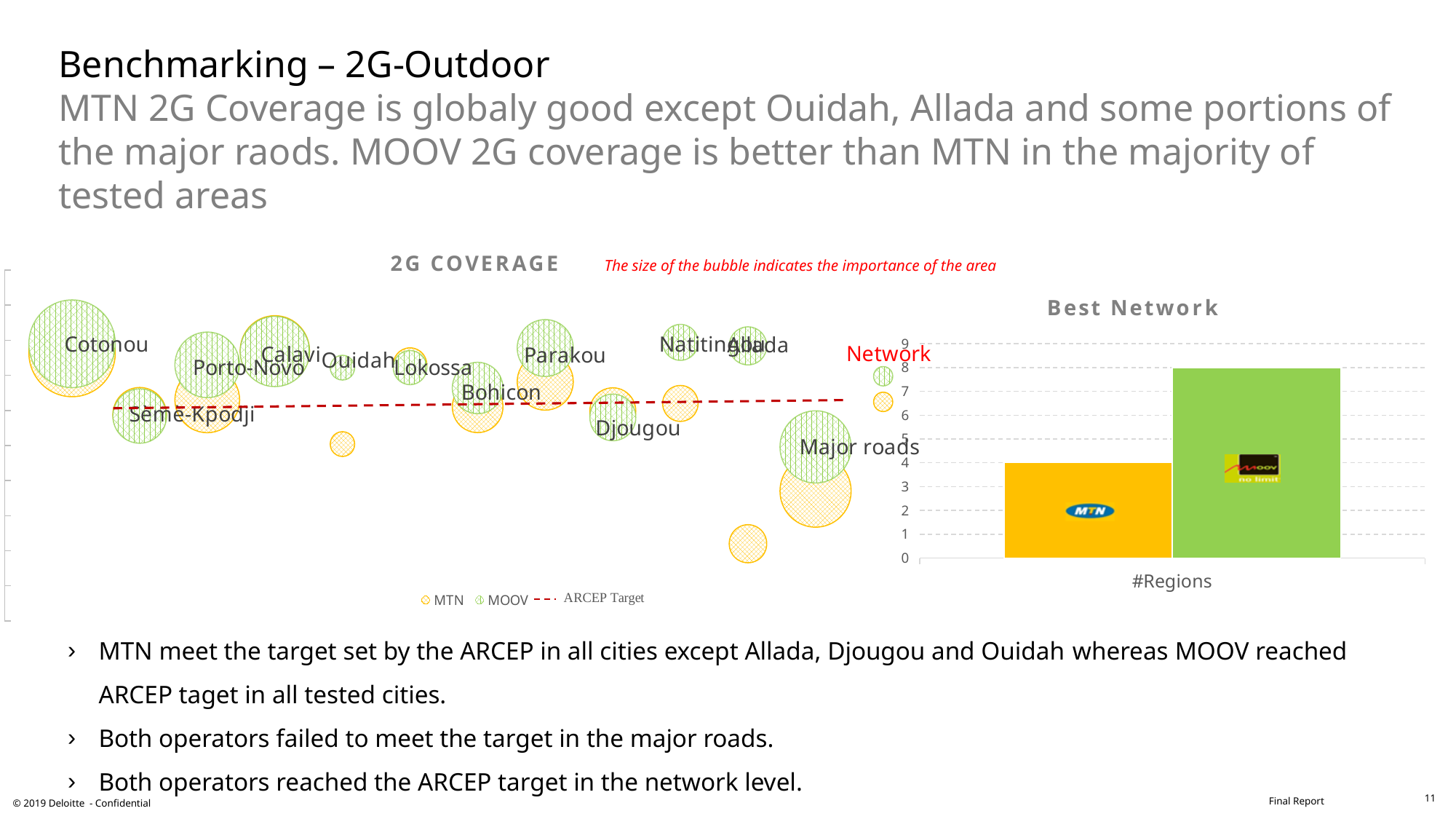
How many entries does the legend of the 2G COVERAGE chart list? 3 In the Best Network chart, what is the value for MOOV? 8 In the Best Network chart, is the value for MOOV greater or less than 6? greater In the Best Network chart, is the value for MTN greater or less than 5? less In the Best Network chart, which operator has the higher number of regions? MOOV What is the x-axis category label in the Best Network chart? #Regions In the Best Network chart, which operator has the lower number of regions? MTN In the Best Network chart, what is the difference between the MOOV and MTN values? 4 In the Best Network chart, what is the value for MTN? 4 What kind of chart is the Best Network chart? bar chart In the 2G COVERAGE chart, what does the size of the bubble indicate? The importance of the area What kind of chart is the 2G COVERAGE chart? bubble chart